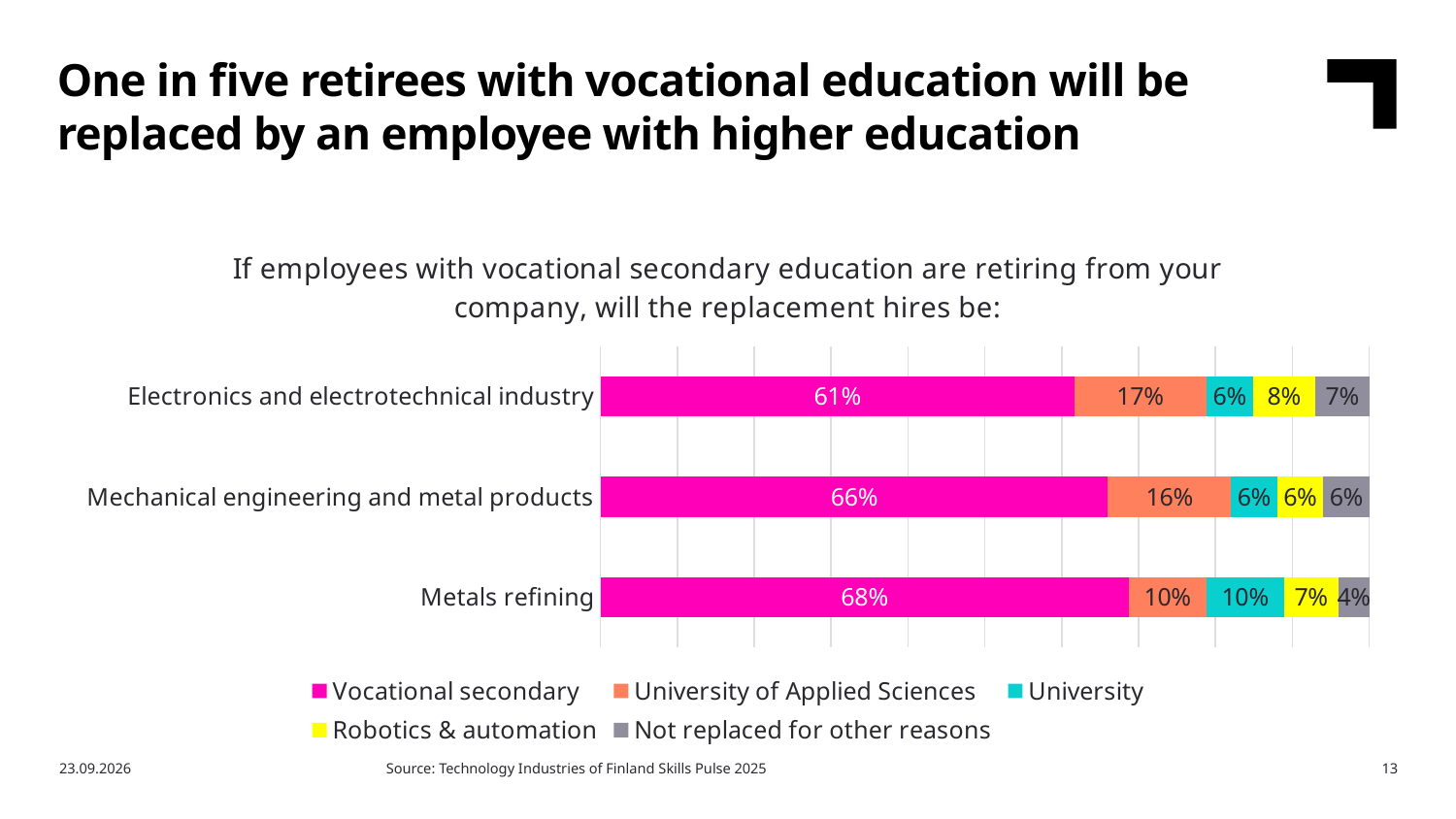
Which series is shown in yellow in the legend? Robotics & automation What is the Vocational secondary value for Metals refining? 68% Which industry has the highest Vocational secondary value? Metals refining What is the University of Applied Sciences value for Electronics and electrotechnical industry? 17% What is the difference between the Vocational secondary values for Metals refining and Electronics and electrotechnical industry? 7% How many series does the legend list? 5 How many industry categories are plotted in the chart? 3 What kind of chart is shown on the slide? Stacked bar chart What is the Robotics & automation value for Mechanical engineering and metal products? 6% What is the Not replaced for other reasons value for Metals refining? 4% Which is larger: the University value for Metals refining or for Mechanical engineering and metal products? Metals refining Which industry has the lowest University of Applied Sciences value? Metals refining